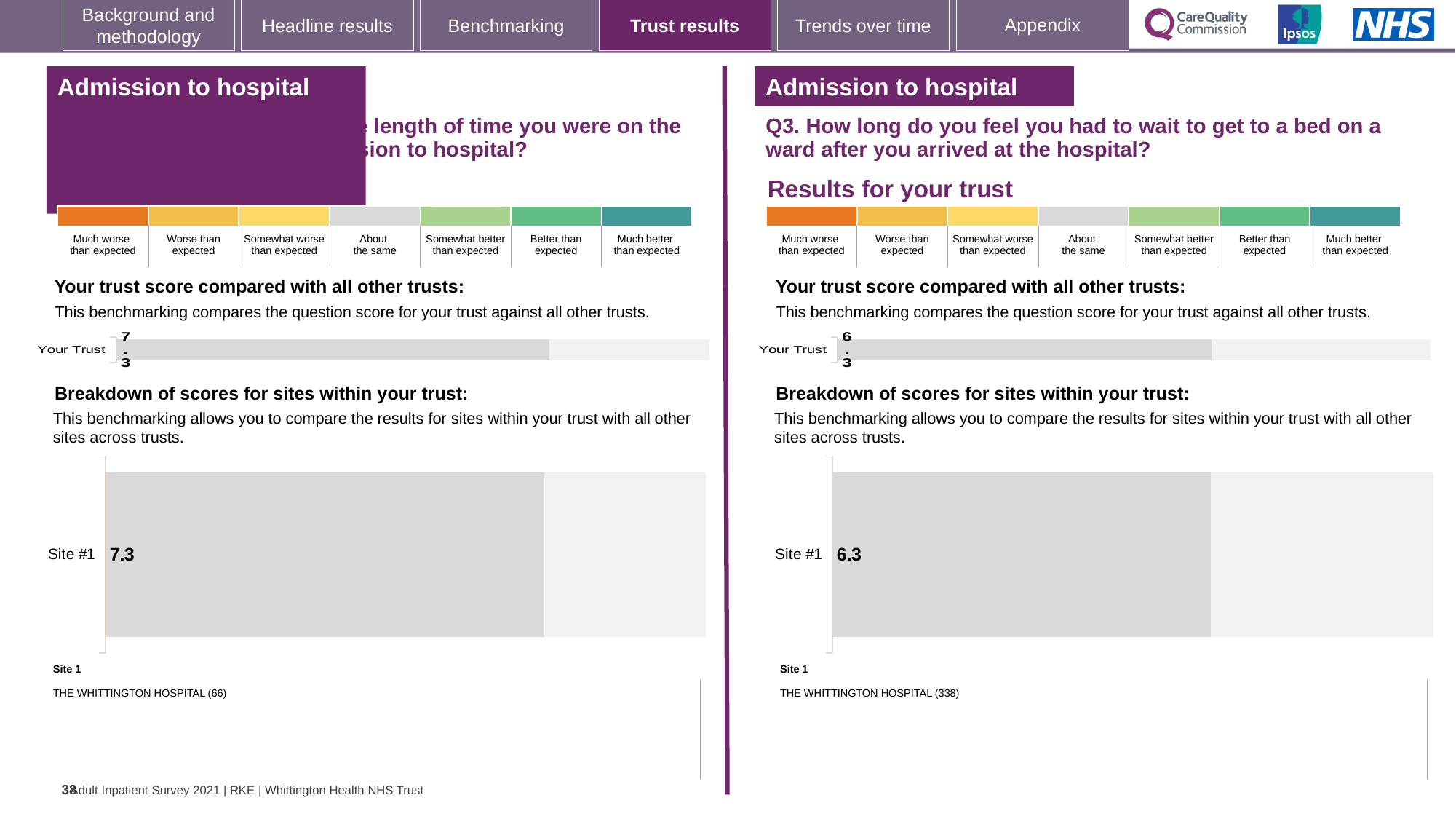
How many categories does the colour key above the charts list, from 'Much worse than expected' to 'Much better than expected'? 7 What kind of chart is used to show the Your Trust score on the left half of the slide? Bar chart Which hospital is listed as Site 1 on the right half of the slide (Q3)? THE WHITTINGTON HOSPITAL (338) How many sites are shown in the left 'Breakdown of scores for sites within your trust' chart? 1 On the left half of the slide, what is the score shown for Your Trust in the 'Your trust score compared with all other trusts' chart? 7.3 In the left 'Breakdown of scores for sites within your trust' chart, what is the score for Site #1? 7.3 What kind of chart is used to show the Site #1 score on the right half of the slide (Q3)? Bar chart In the right 'Breakdown of scores for sites within your trust' chart (Q3), what is the score for Site #1? 6.3 What is the difference between the Site #1 score in the left breakdown chart and the Site #1 score in the right breakdown chart (Q3)? 1.0 How many sites are shown in the right 'Breakdown of scores for sites within your trust' chart (Q3)? 1 Which is larger: the Your Trust score on the left half of the slide or the Your Trust score on the right half (Q3)? Left half (7.3) On the right half of the slide (Q3), what is the score shown for Your Trust in the 'Your trust score compared with all other trusts' chart? 6.3